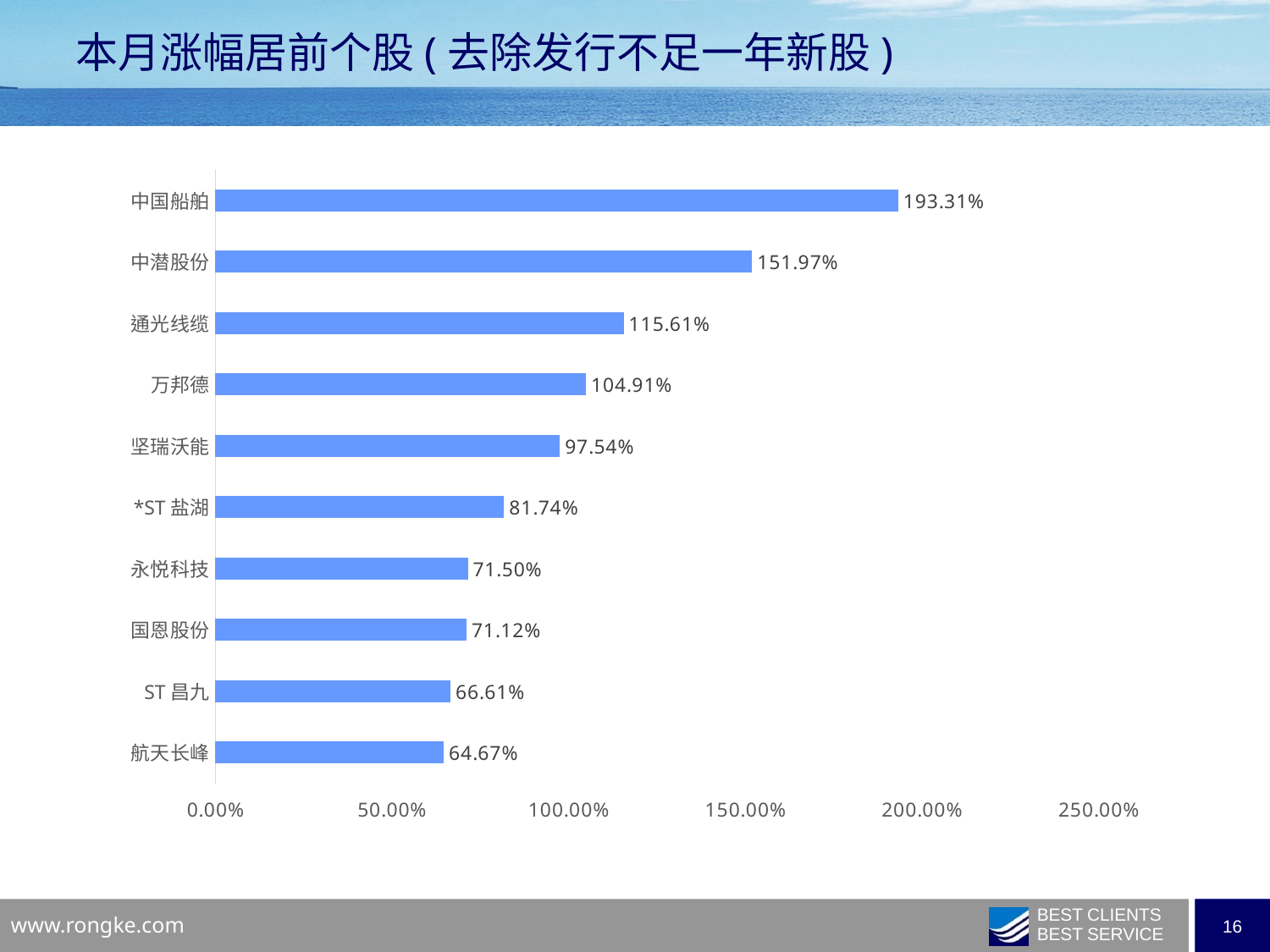
What is the value shown for 中国船舶? 193.31% Which stock has the lowest value in the chart? 航天长峰 How many stocks are shown in the chart? 10 What is the value shown for 万邦德? 104.91% Which stock has the highest value in the chart? 中国船舶 Is the value for 坚瑞沃能 greater or less than 100.00%? less What is the difference between the values for 通光线缆 and 万邦德? 10.70% Which has a larger value, 中潜股份 or 通光线缆? 中潜股份 What is the difference between the values for 中国船舶 and 中潜股份? 41.34% What is the title of the slide? 本月涨幅居前个股 ( 去除发行不足一年新股 ) What is the value shown for 航天长峰? 64.67% What kind of chart is shown on the slide? bar chart